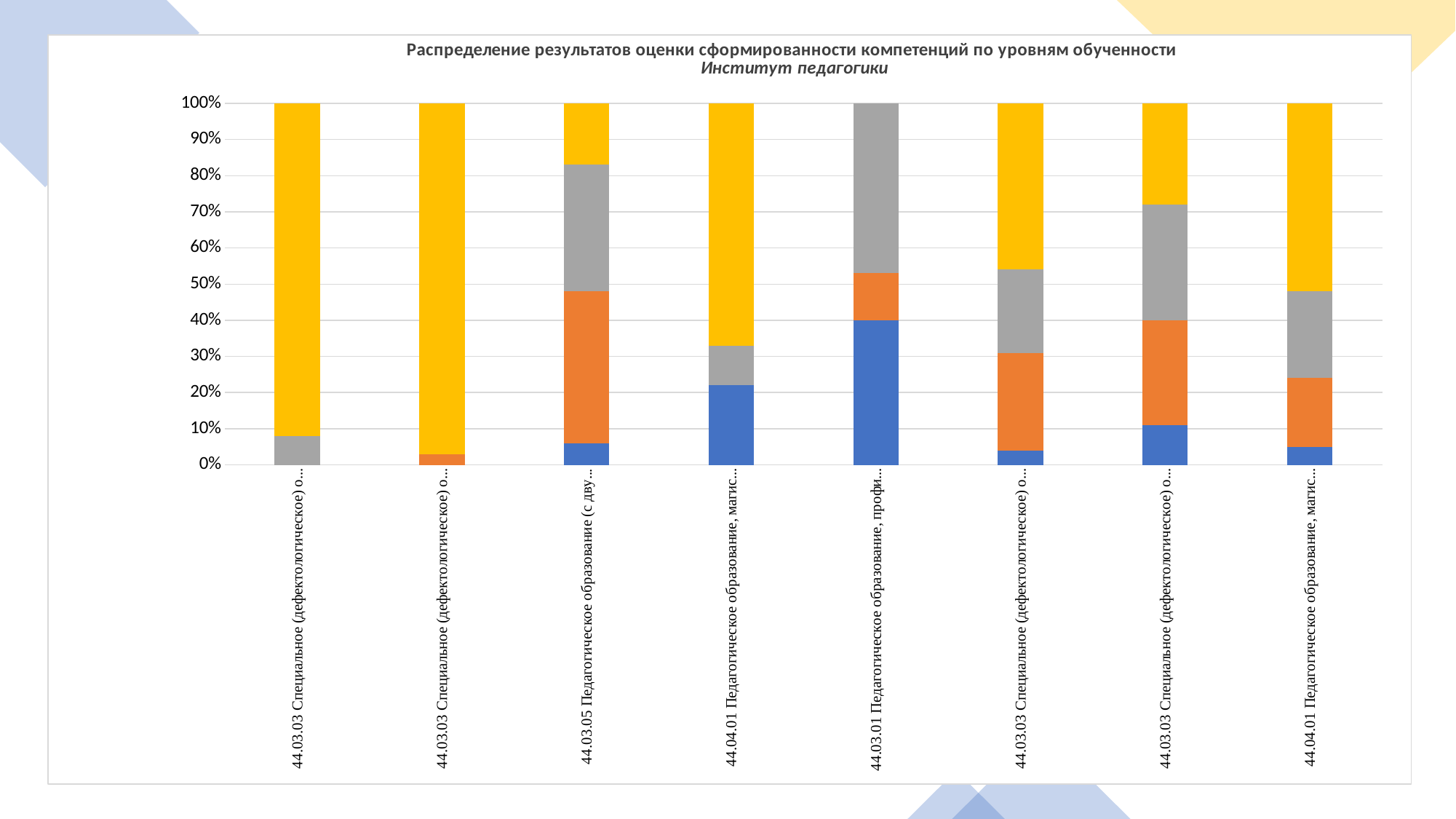
What kind of chart is shown on the slide? Stacked bar chart In the third bar from the left, is the top of the grey segment greater or less than 80%? greater How many bars (categories) are plotted in the chart? 8 Which bar has the larger blue segment, the fourth or the fifth from the left? The fifth from the left Which bar has no yellow segment at all? The fifth bar from the left (44.03.01 Педагогическое образование, профи...) In the fourth bar from the left, is the top of the blue segment greater or less than 30%? less In the fifth bar from the left, is the top of the blue segment greater or less than 30%? greater Which bar has the larger orange segment, the third or the sixth from the left? The third from the left What is the first line of the chart's title? Распределение результатов оценки сформированности компетенций по уровням обученности Which bar has the largest yellow segment? The second bar from the left